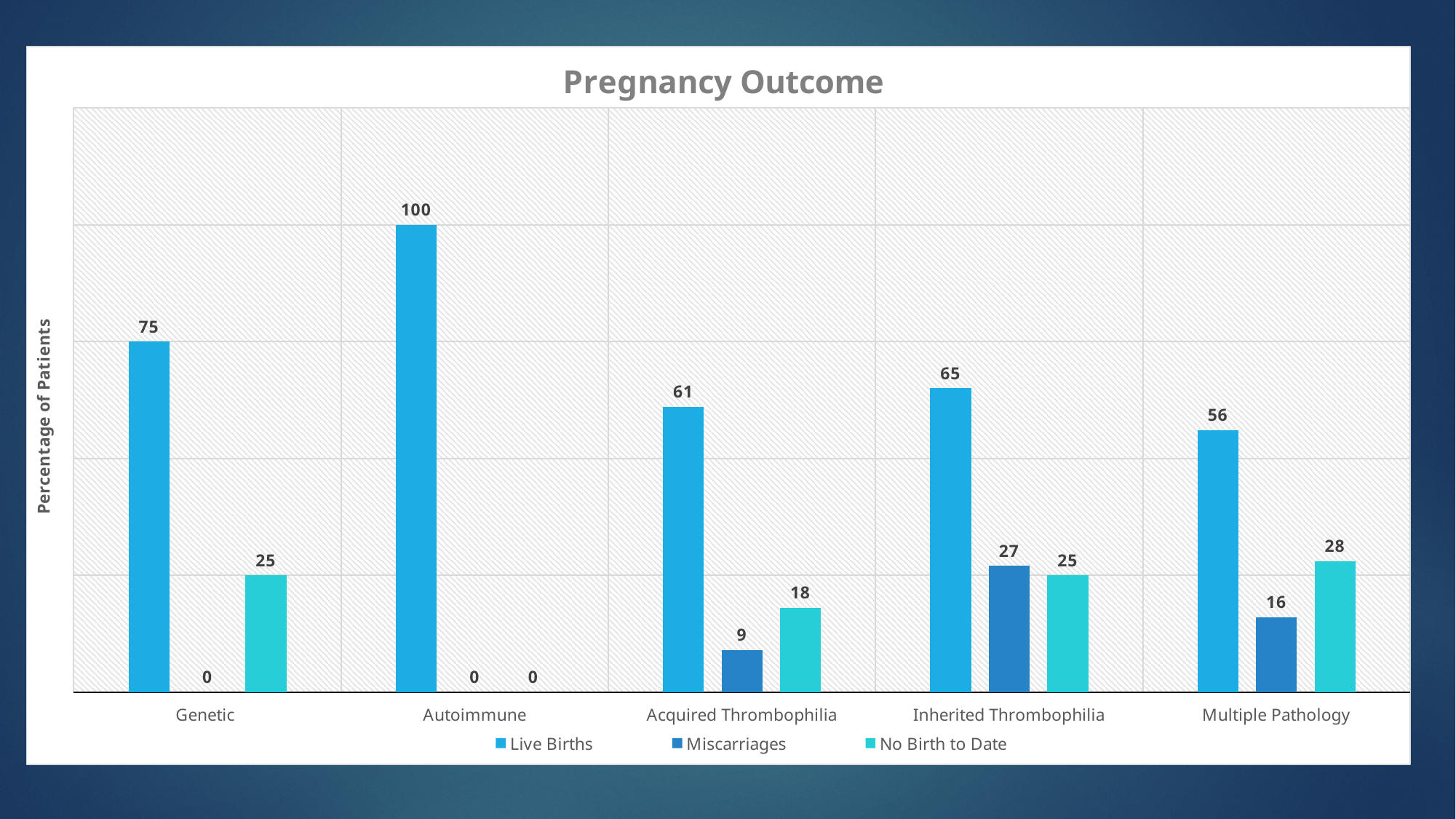
How many categories are shown on the x axis? 5 How many series does the legend list? 3 What is the title of the chart? Pregnancy Outcome What is the Live Births value for Autoimmune? 100 Which category has the highest Live Births value? Autoimmune What is the Miscarriages value for Genetic? 0 What kind of chart is shown? Bar chart Which category has the lowest Live Births value? Multiple Pathology What is the difference between the Live Births values for Genetic and Acquired Thrombophilia? 14 What is the No Birth to Date value for Multiple Pathology? 28 Which is larger, the No Birth to Date value for Acquired Thrombophilia or for Inherited Thrombophilia? Inherited Thrombophilia What is the Miscarriages value for Inherited Thrombophilia? 27